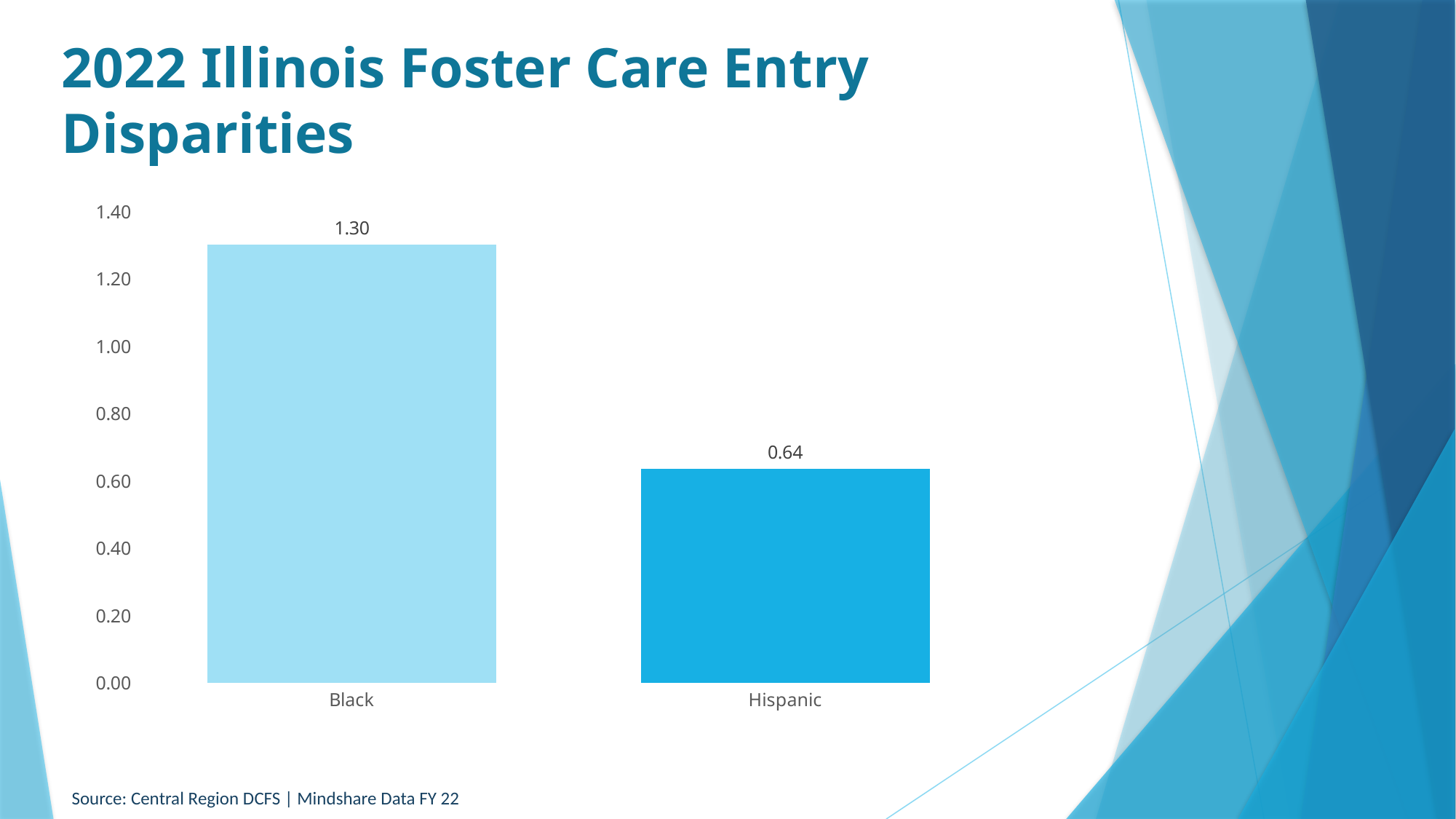
What is the highest value shown on the vertical axis? 1.40 Which category has the highest value? Black What kind of chart is shown on the slide? bar chart How many categories are shown in the chart? 2 What is the value for Hispanic? 0.64 Which is larger, the value for Black or the value for Hispanic? Black Is the value for Black greater or less than 1.00? greater What is the title of the slide? 2022 Illinois Foster Care Entry Disparities Which category has the lowest value? Hispanic What is the value for Black? 1.30 Is the value for Hispanic greater or less than 0.80? less What is the difference between the values for Black and Hispanic? 0.66